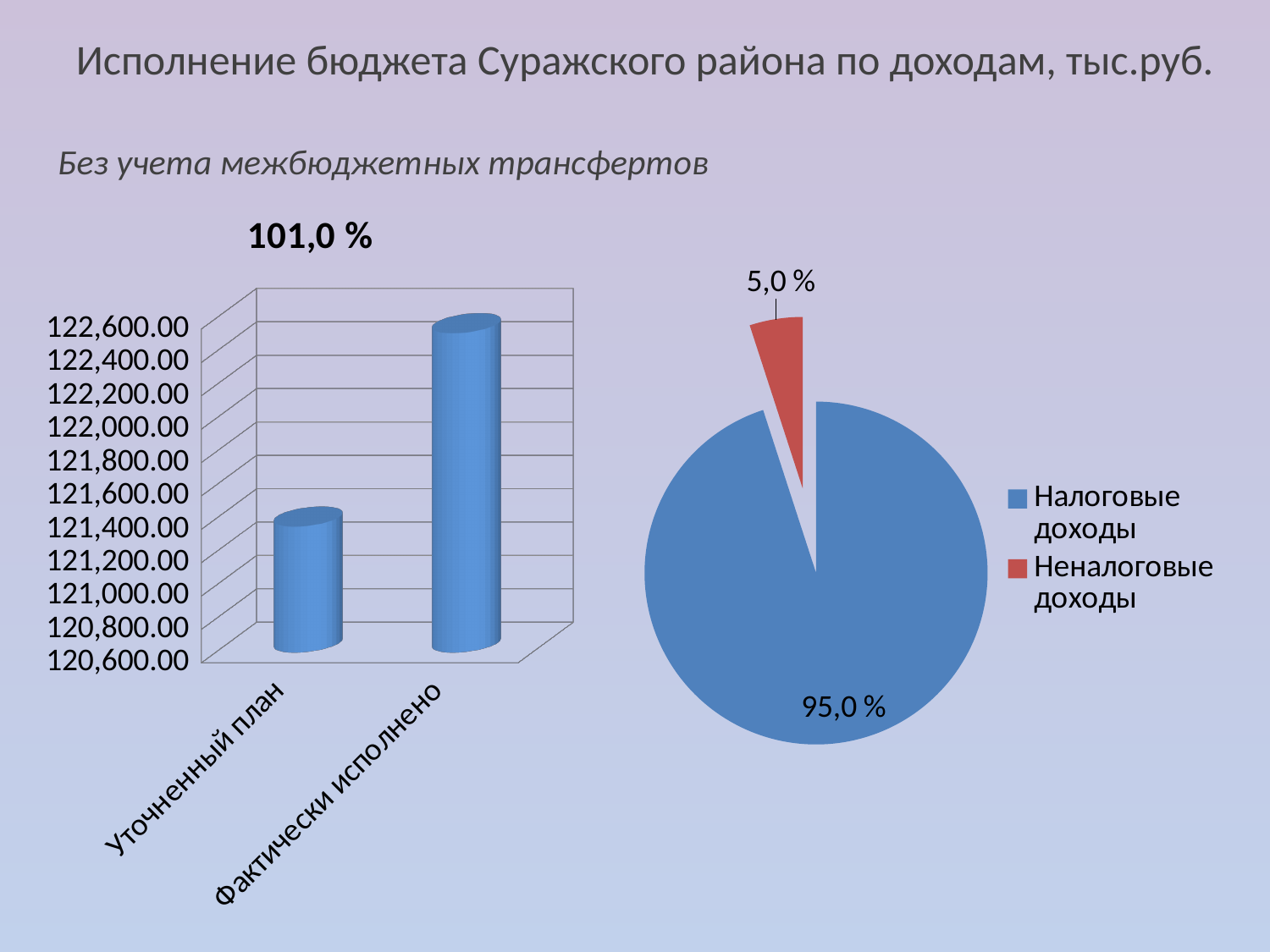
In the left bar chart, is the value for Фактически исполнено greater or less than 122,000.00? greater In the left bar chart, which category has the lower value? Уточненный план In the left bar chart, is the value for Уточненный план greater or less than 122,000.00? less What percentage figure is printed above the left bar chart? 101,0 % What kind of chart is the left chart on the slide? bar chart In the left bar chart, which category has the higher value? Фактически исполнено How many categories does the left bar chart show? 2 What kind of chart is the right chart on the slide? pie chart In the right pie chart, what share is shown for Неналоговые доходы? 5,0 % How many entries does the legend of the right pie chart list? 2 In the left bar chart, is the value for Фактически исполнено larger or smaller than the value for Уточненный план? larger In the right pie chart, what share is shown for Налоговые доходы? 95,0 %